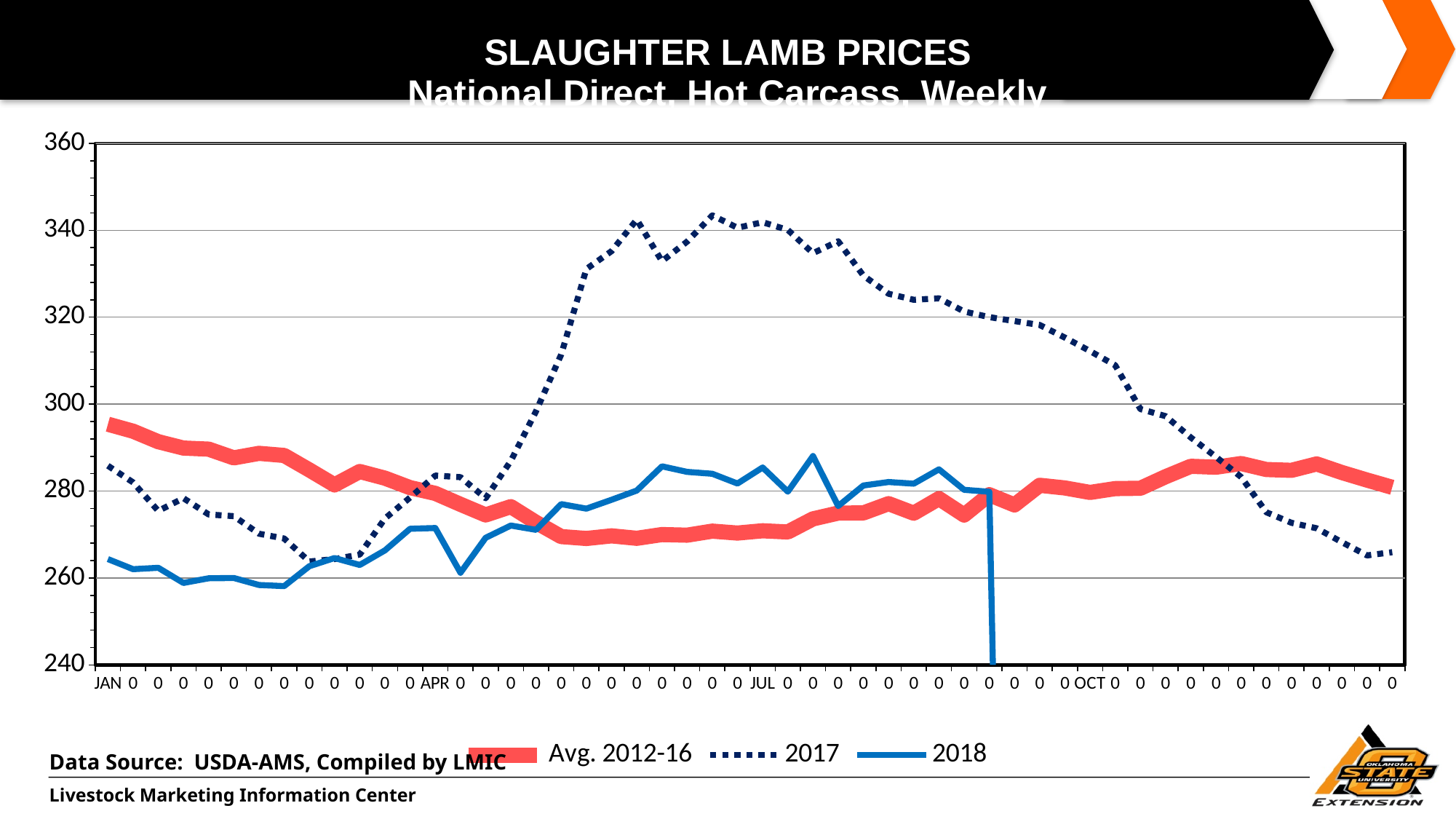
Is the 2017 value at the far right end of the chart greater or less than 280? less Is the Avg. 2012-16 value at JAN greater or less than 280? greater Which series reaches the highest value anywhere on the chart? 2017 Is the 2017 value around JUL greater or less than 320? greater At JUL, which is higher, the 2017 series or the 2018 series? 2017 Does the 2017 series rise or fall between JUL and OCT? fall How many series does the legend list? 3 What kind of chart is shown on the slide? line chart At JAN, which is higher, the Avg. 2012-16 series or the 2018 series? Avg. 2012-16 What is the title of the chart? SLAUGHTER LAMB PRICES National Direct, Hot Carcass, Weekly Which series is drawn as a dotted line? 2017